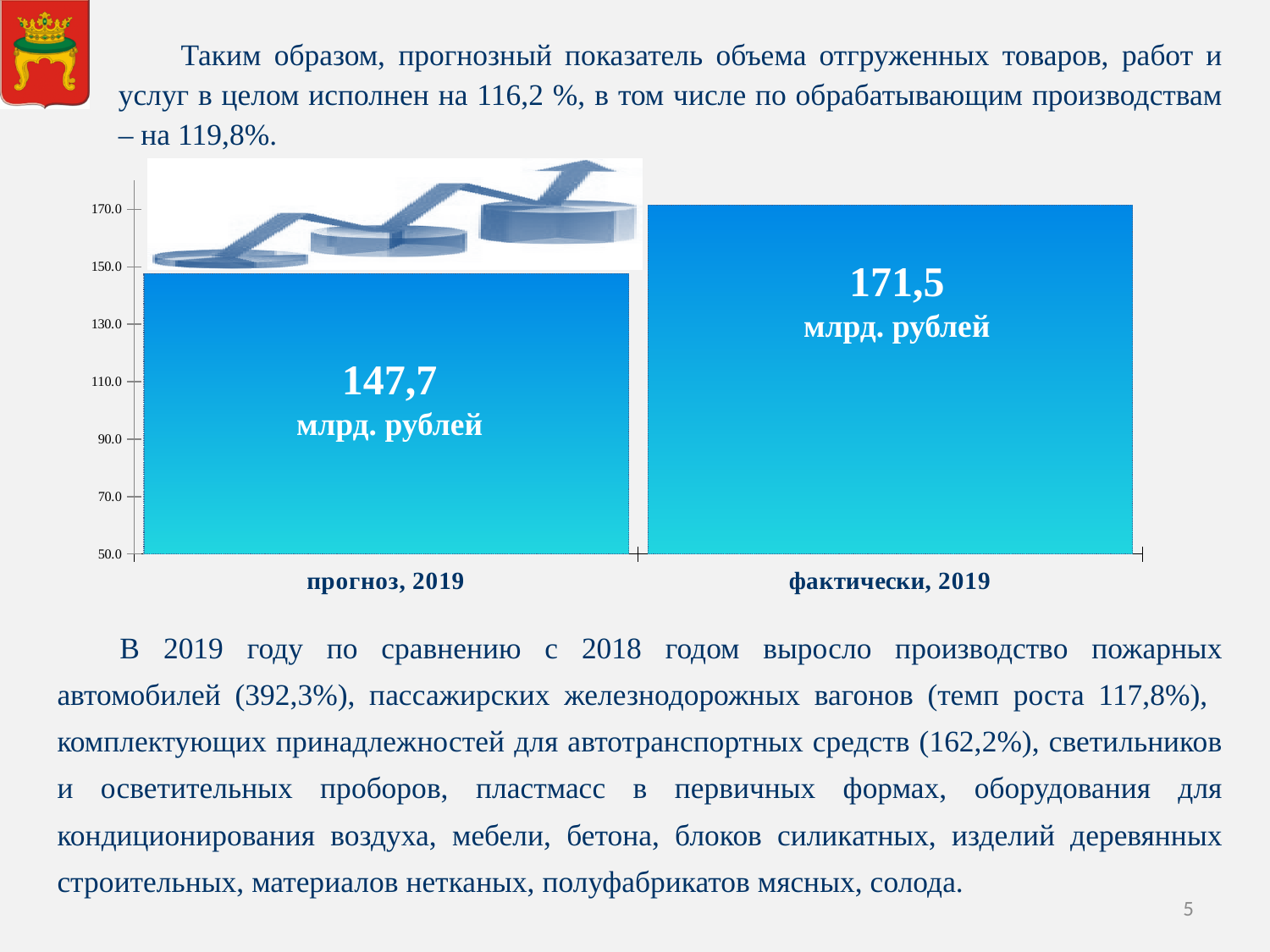
Is the value for "прогноз, 2019" greater or less than 150.0? less Is the value for "фактически, 2019" greater or less than 170.0? greater Is the value for "прогноз, 2019" larger or smaller than the value for "фактически, 2019"? smaller What is the value shown for the bar labelled "фактически, 2019"? 171,5 млрд. рублей Which category has the lower value on the chart? прогноз, 2019 What is the value shown for the bar labelled "прогноз, 2019"? 147,7 млрд. рублей Do the values rise or fall from the left bar to the right bar? rise Which category has the higher value, "прогноз, 2019" or "фактически, 2019"? фактически, 2019 How many bars are plotted on the chart? 2 By how much does the value for "фактически, 2019" exceed the value for "прогноз, 2019"? 23,8 млрд. рублей What is the lowest value labelled on the vertical axis of the chart? 50.0 What kind of chart is shown on the slide? bar chart